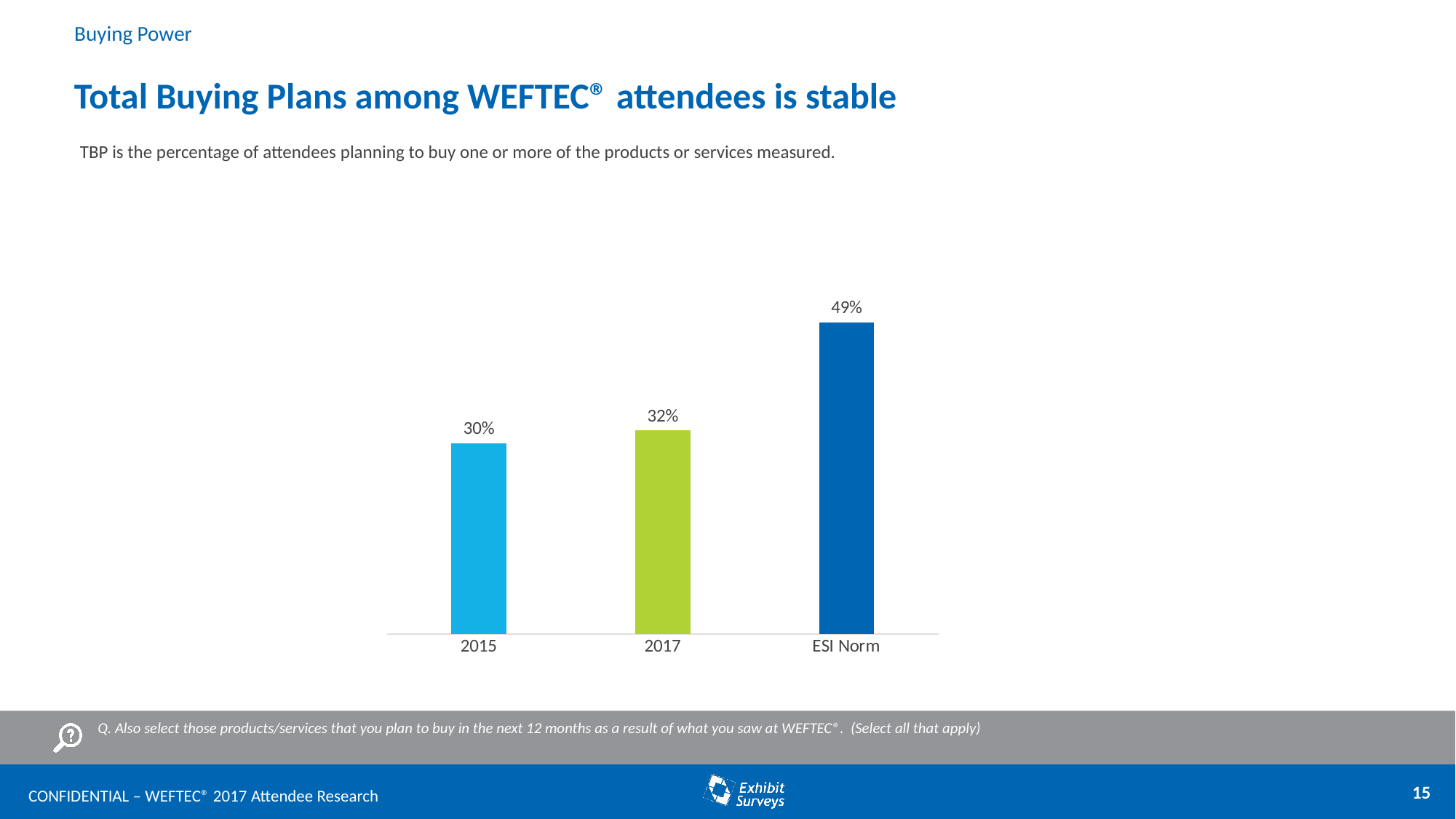
What is the value for 2015? 30% What kind of chart is shown on the slide? Bar chart How many bars are shown in the chart? 3 What is the difference between the ESI Norm value and the 2017 value? 17% What is the difference between the 2017 value and the 2015 value? 2% Which category has the highest value? ESI Norm Which is larger, the value for 2015 or the value for ESI Norm? ESI Norm Do the values rise or fall from 2015 to 2017? Rise What is the value for ESI Norm? 49% What is the value for 2017? 32% What colour is the bar for ESI Norm? Dark blue Which category has the lowest value? 2015